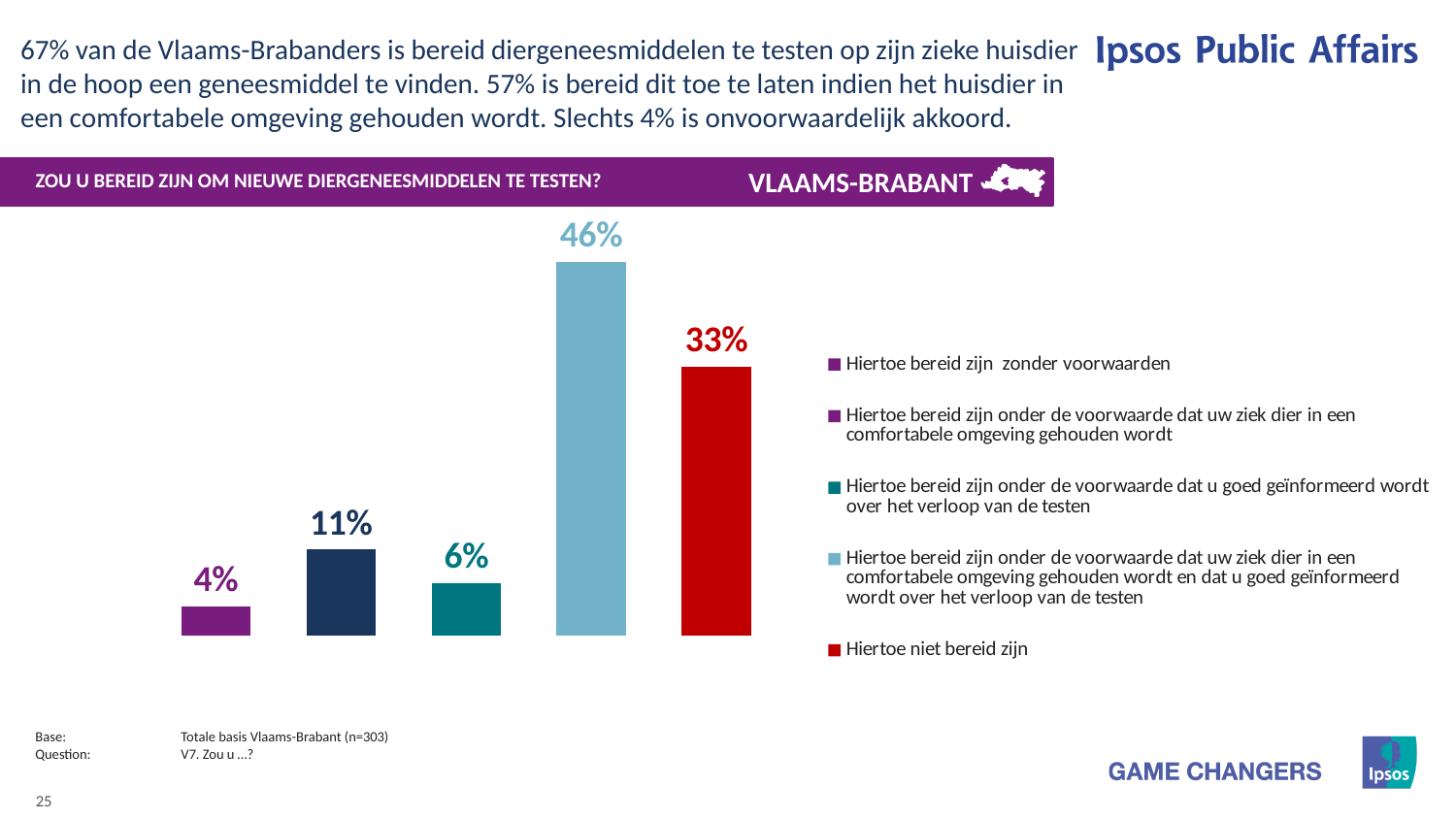
Which category has the lowest value in the chart? Hiertoe bereid zijn zonder voorwaarden What is the value for "Hiertoe niet bereid zijn"? 33% How many bars are shown in the chart? 5 What type of chart is shown on the slide? Bar chart What is the difference between the highest bar (46%) and the "Hiertoe niet bereid zijn" bar (33%)? 13% What colour is the bar for "Hiertoe niet bereid zijn"? Red Which is larger: the value for "Hiertoe bereid zijn onder de voorwaarde dat uw ziek dier in een comfortabele omgeving gehouden wordt" or the value for "Hiertoe bereid zijn onder de voorwaarde dat u goed geïnformeerd wordt over het verloop van de testen"? Hiertoe bereid zijn onder de voorwaarde dat uw ziek dier in een comfortabele omgeving gehouden wordt What percentage of respondents are willing to test new veterinary medicines without conditions ("Hiertoe bereid zijn zonder voorwaarden")? 4% What is the value for "Hiertoe bereid zijn onder de voorwaarde dat u goed geïnformeerd wordt over het verloop van de testen"? 6% What is the value for the category where the sick animal is kept in a comfortable environment and the respondent is well informed about the course of the tests? 46% How many entries does the legend list? 5 Which category has the highest value in the chart? Hiertoe bereid zijn onder de voorwaarde dat uw ziek dier in een comfortabele omgeving gehouden wordt en dat u goed geïnformeerd wordt over het verloop van de testen